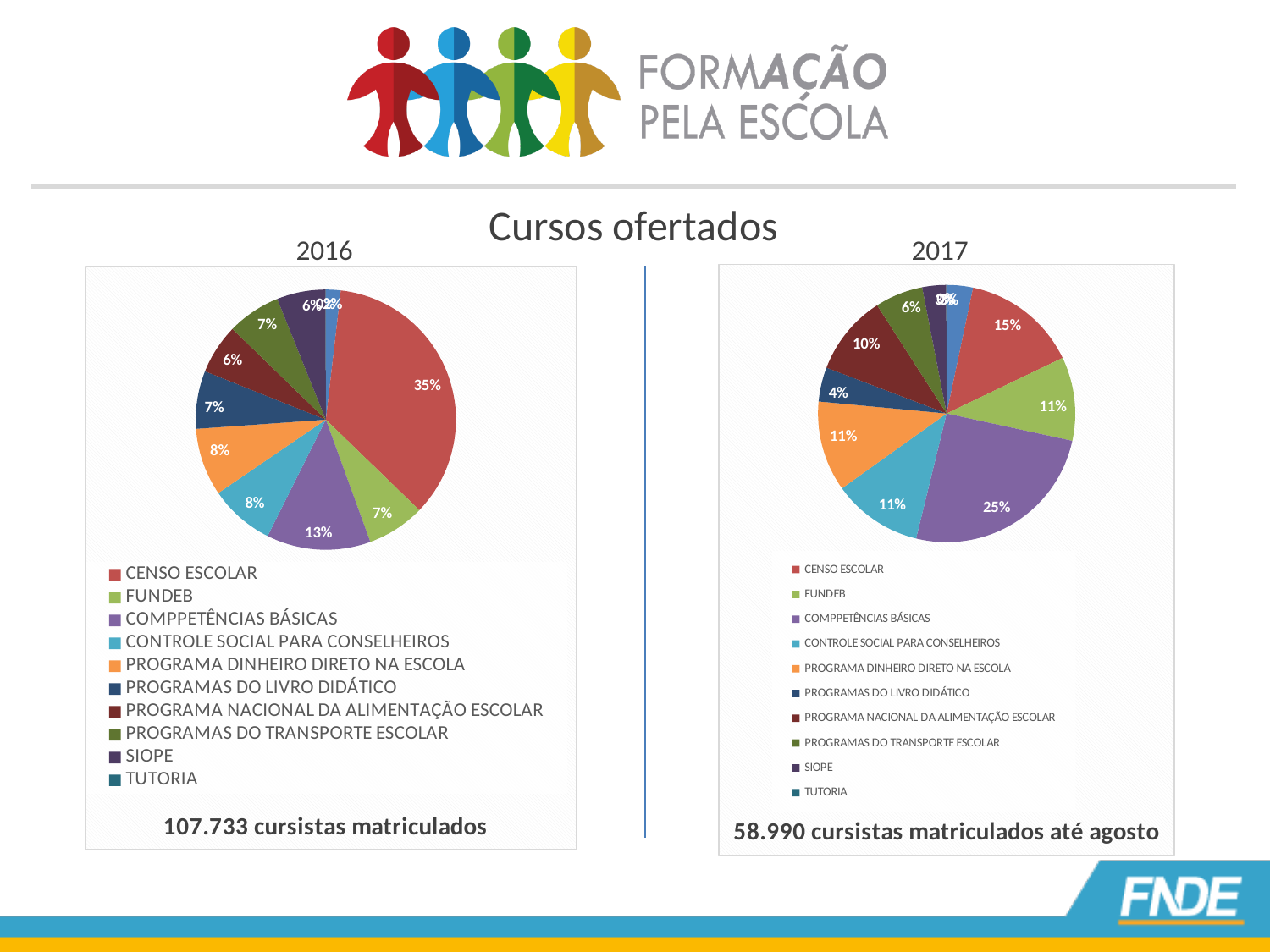
What type of chart is used for the 2017 data? Pie chart According to the text below the 2016 chart, how many cursistas were matriculados in 2016? 107.733 What is the title shown above the two charts? Cursos ofertados In the 2016 pie chart, what share does COMPPETÊNCIAS BÁSICAS have? 13% In the 2017 pie chart, what share does PROGRAMAS DO LIVRO DIDÁTICO have? 4% In the 2017 pie chart, what share does COMPPETÊNCIAS BÁSICAS have? 25% In the 2017 pie chart, what is the difference between the shares of CENSO ESCOLAR and PROGRAMA NACIONAL DA ALIMENTAÇÃO ESCOLAR? 5% In the 2016 pie chart, which is larger: the share of CENSO ESCOLAR or the share of COMPPETÊNCIAS BÁSICAS? CENSO ESCOLAR In the 2016 pie chart, what share does CENSO ESCOLAR have? 35% In the 2016 pie chart, which course has the largest share? CENSO ESCOLAR How many courses are listed in the legend of the 2016 pie chart? 10 In the 2017 pie chart, which course has the largest share? COMPPETÊNCIAS BÁSICAS